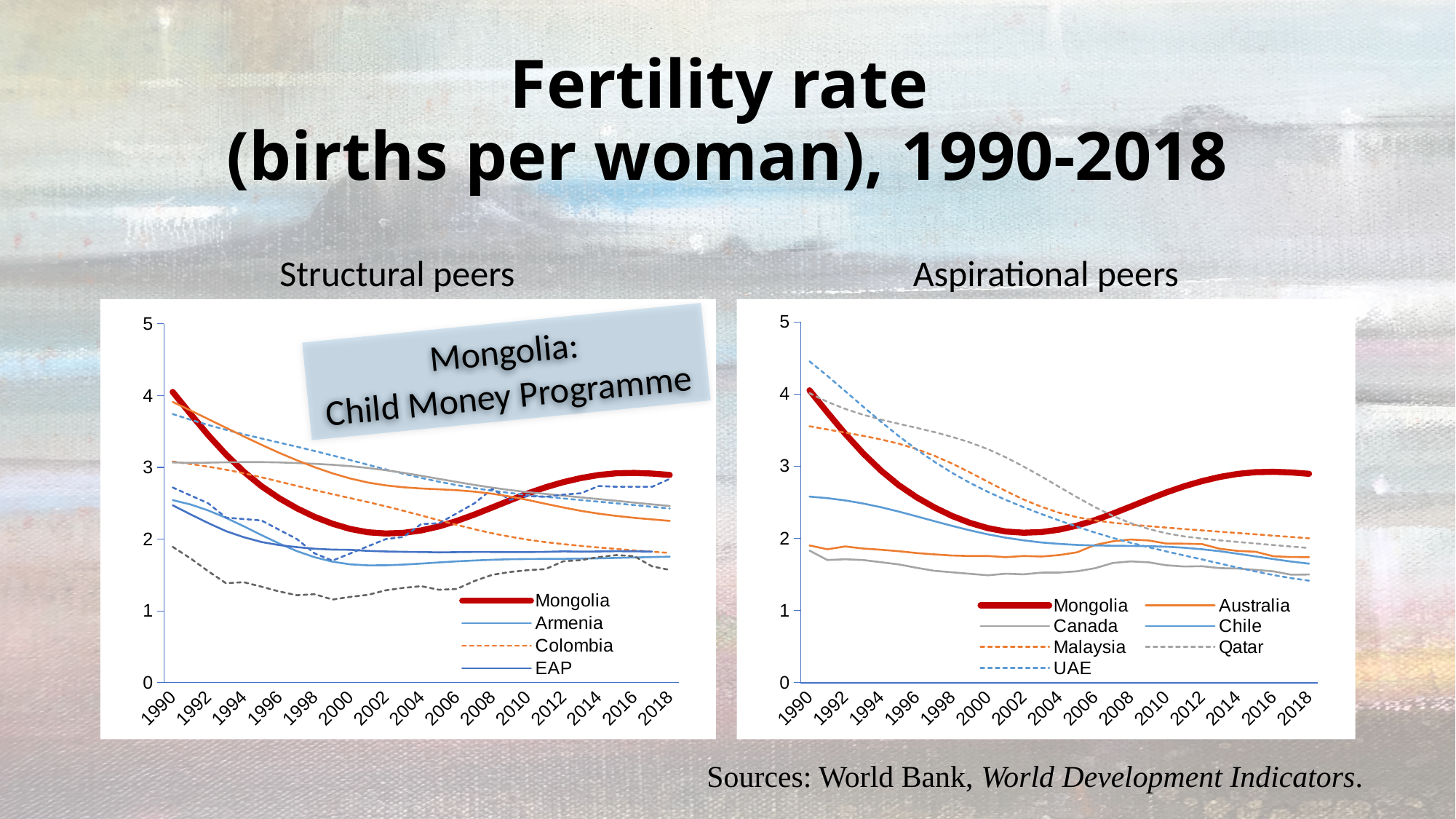
In the Aspirational peers chart, is the value for Chile in 1990 greater or less than 2? greater How many series does the legend of the Structural peers chart list? 4 How many series does the legend of the Aspirational peers chart list? 7 In the Aspirational peers chart, is the value for UAE in 1990 greater or less than 4? greater In the Structural peers chart, which is higher in 1990, Mongolia or EAP? Mongolia What kind of chart is the Structural peers chart? line chart In the Structural peers chart, is the value for Mongolia in 2018 greater or less than 3? less In the Aspirational peers chart, which is higher in 2018, Mongolia or Canada? Mongolia What is the title of the slide? Fertility rate (births per woman), 1990-2018 In the Aspirational peers chart, does the value for Qatar rise or fall from 1990 to 2018? fall In the Aspirational peers chart, which series has the highest value in 1990? UAE